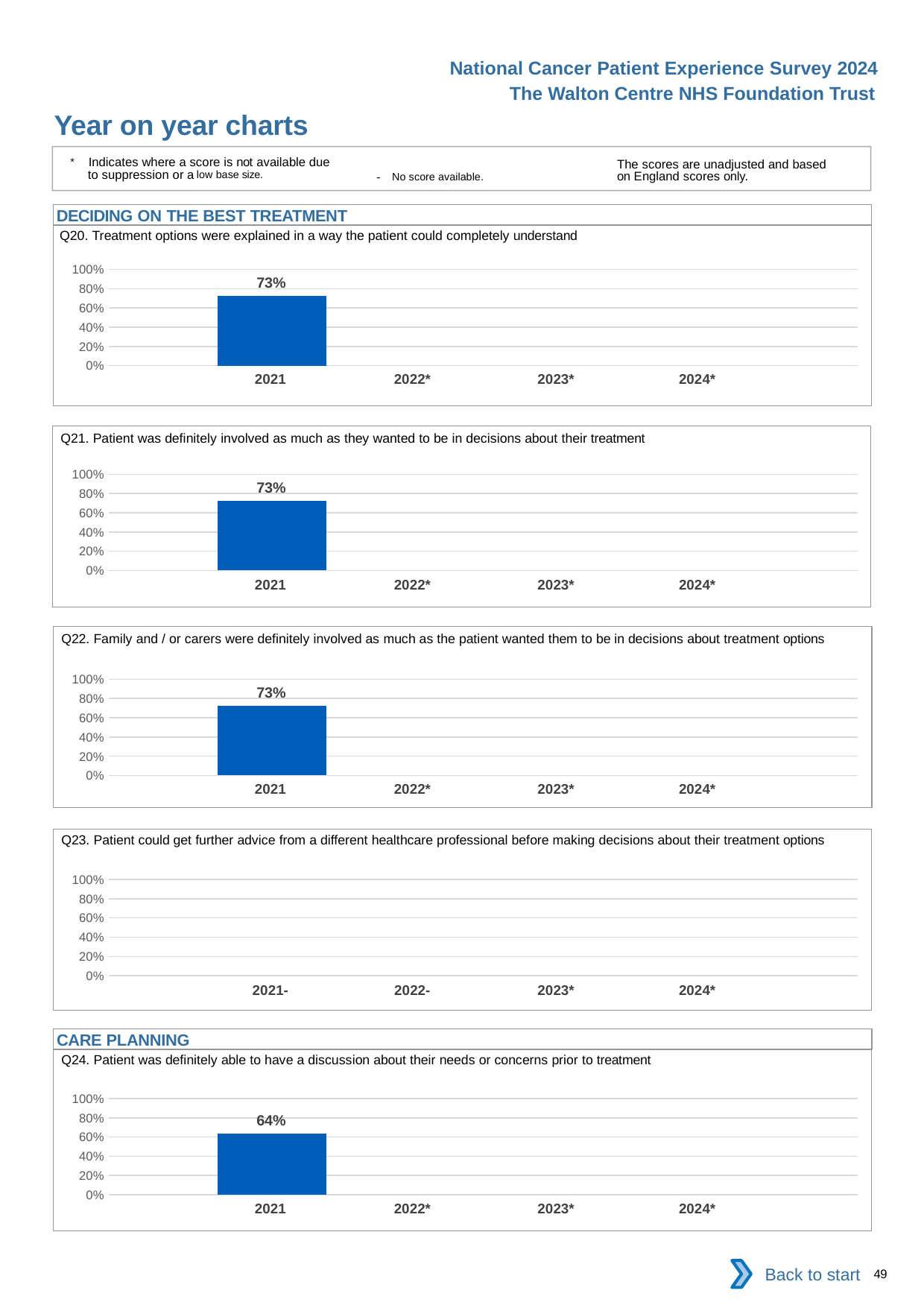
In the Q24 chart, is the value for 2021 greater or less than 80%? less In the Q24 chart, what is the value for 2021? 64% Which is larger: the 2021 value in the Q21 chart or the 2021 value in the Q24 chart? Q21 chart (73%) How many bars are plotted in the Q23 chart? 0 Which section heading appears above the Q24 chart? CARE PLANNING What is the difference between the 2021 value in the Q20 chart and the 2021 value in the Q24 chart? 9 percentage points In the Q21 chart, what is the value for 2021? 73% In the Q22 chart, what is the value for 2021? 73% What kind of chart is the Q20 chart? bar chart In the Q22 chart, is the value for 2021 greater or less than 60%? greater In the Q20 chart, what is the value for 2021? 73% How many year categories are shown on the x axis of the Q23 chart? 4